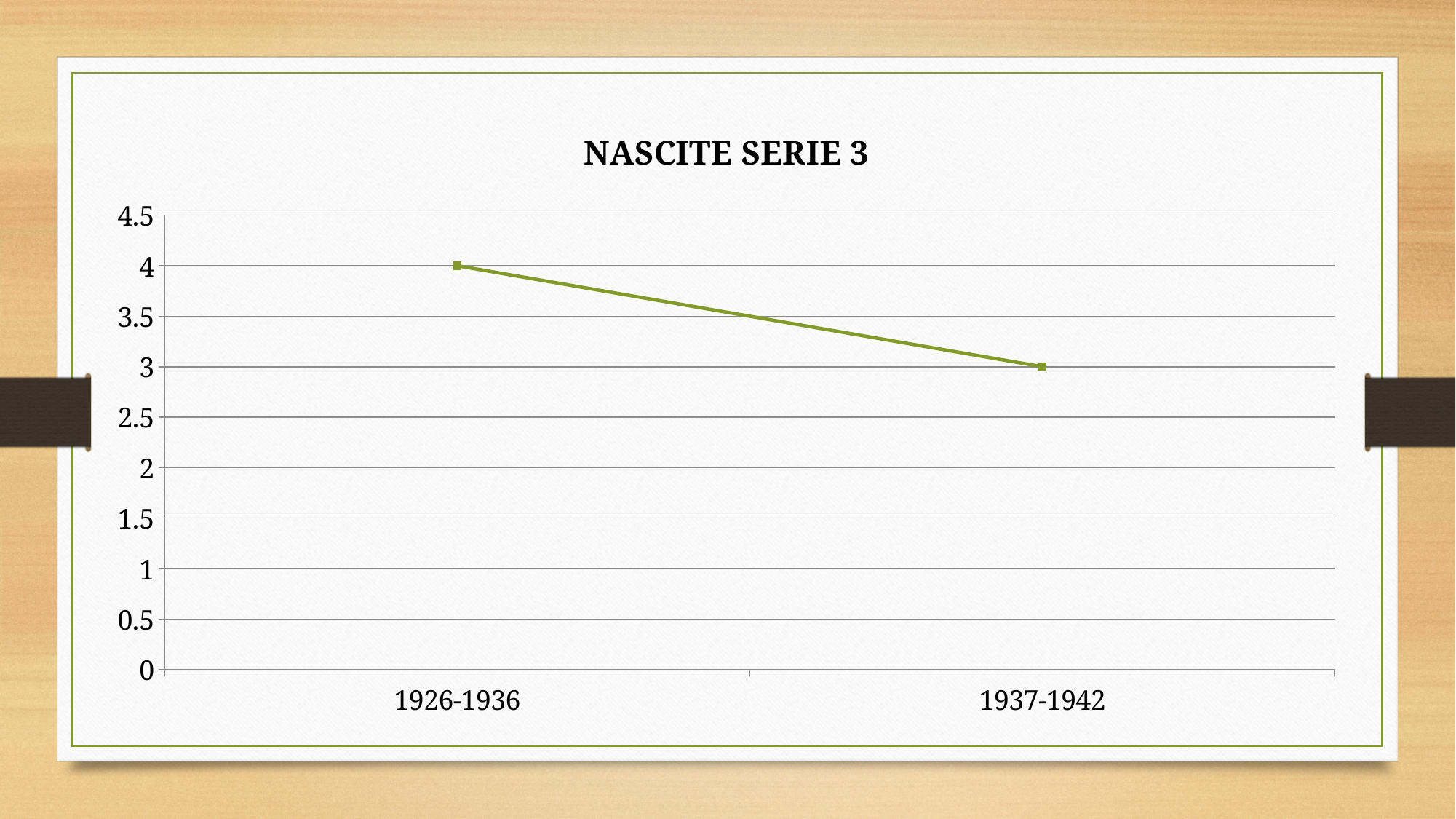
What is the difference between the values for 1926-1936 and 1937-1942? 1 Which period has the lowest value? 1937-1942 What kind of chart is shown on the slide? line chart How many periods are plotted on the x axis? 2 Do the values rise or fall from 1926-1936 to 1937-1942? fall Is the value for 1926-1936 greater or less than 2? greater Which is larger, the value for 1926-1936 or the value for 1937-1942? 1926-1936 Which period has the highest value? 1926-1936 What is the title of the chart? NASCITE SERIE 3 What is the value for 1937-1942? 3 What is the value for 1926-1936? 4 Is the value for 1937-1942 greater or less than 3.5? less